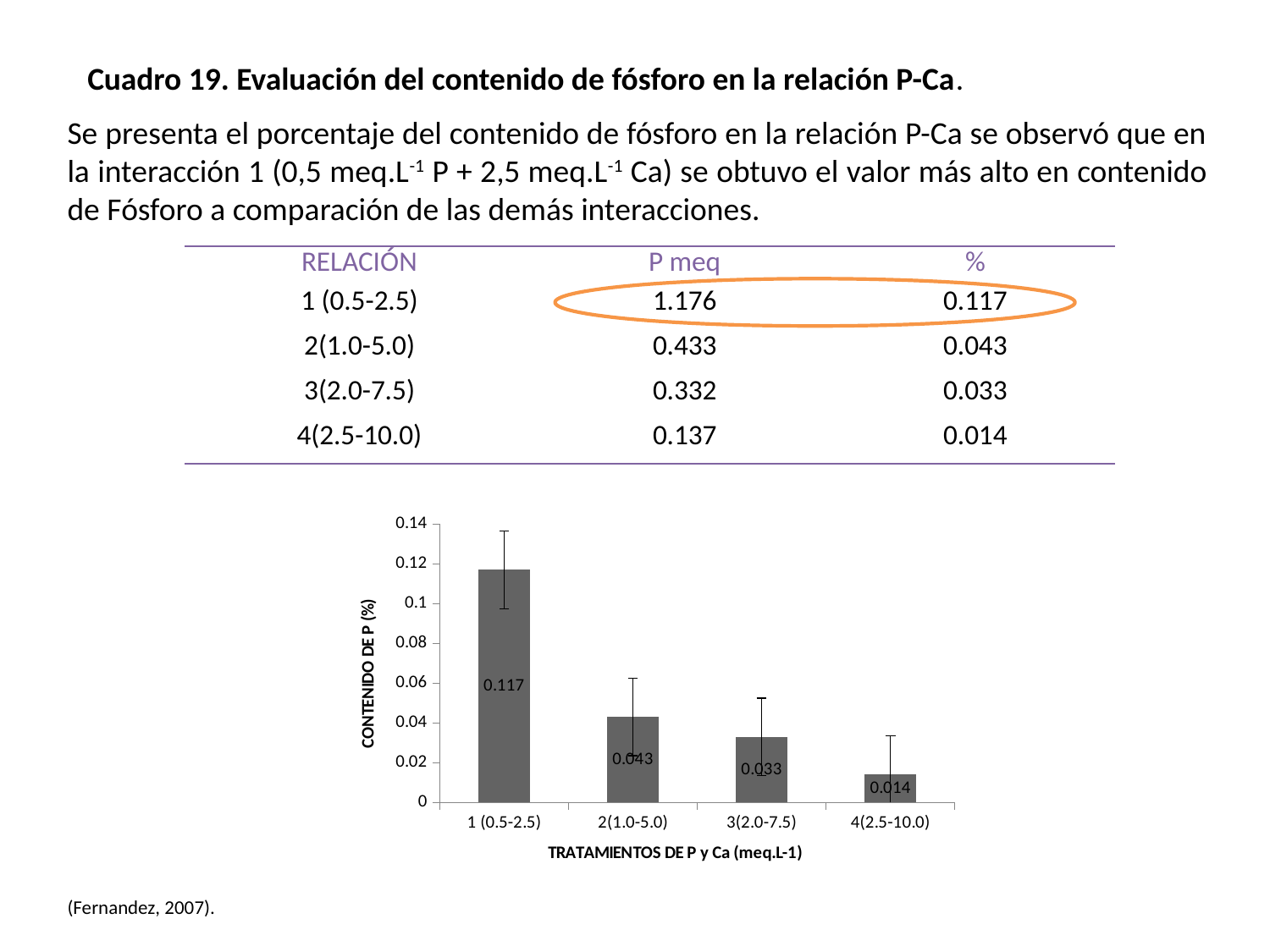
Do the values rise or fall from left to right along the x axis? fall What is the value for 2(1.0-5.0) in the chart? 0.043 What is the value for 3(2.0-7.5) in the chart? 0.033 Is the value for 1 (0.5-2.5) greater or less than 0.1? greater How many treatments are shown on the x axis of the chart? 4 Which treatment has the highest P content in the chart? 1 (0.5-2.5) What is the value for 1 (0.5-2.5) in the chart? 0.117 What kind of chart is shown on the slide? bar chart Which treatment has the lowest P content in the chart? 4(2.5-10.0) What is the difference between the values for 1 (0.5-2.5) and 2(1.0-5.0)? 0.074 Which is larger, the value for 3(2.0-7.5) or the value for 4(2.5-10.0)? 3(2.0-7.5) What is the value for 4(2.5-10.0) in the chart? 0.014